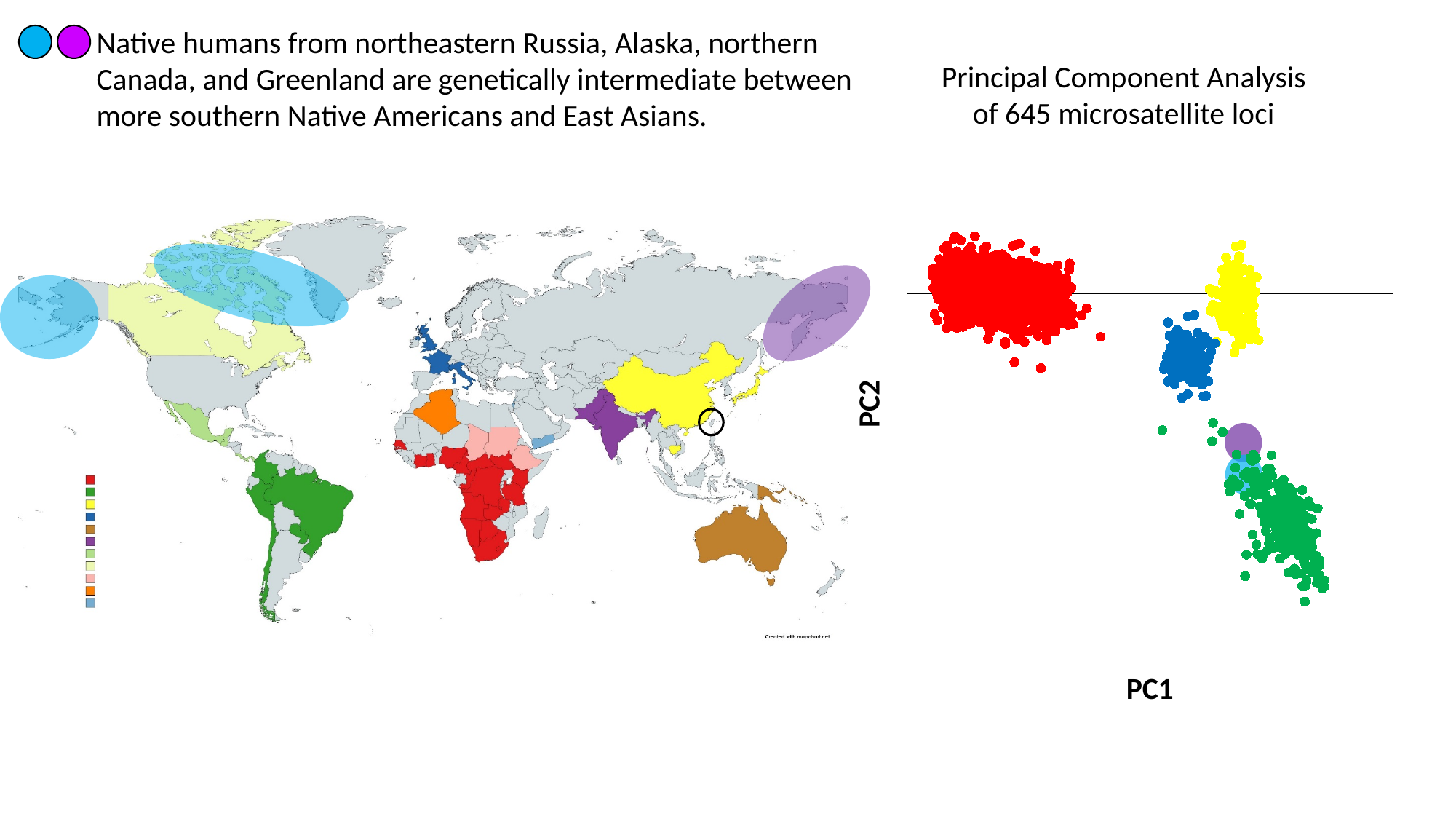
In the PCA chart, which cluster is lower along PC2, the blue cluster or the green cluster? green In the PCA chart, which cluster is higher along PC2, the yellow cluster or the blue cluster? yellow In the PCA chart, what are the labels of the horizontal and vertical axes? PC1 and PC2 In the PCA chart, which coloured cluster extends furthest to the right along PC1? green What kind of chart is the 'Principal Component Analysis of 645 microsatellite loci' chart? scatter plot In the PCA chart, is the red cluster on the left or the right side of the vertical PC2 axis line? left In the PCA chart, how many distinct coloured clusters of points are plotted? 4 In the PCA chart, which coloured cluster lies lowest along PC2? green What is the title of the chart on the right of the slide? Principal Component Analysis of 645 microsatellite loci In the PCA chart, which coloured cluster lies furthest to the left along PC1? red